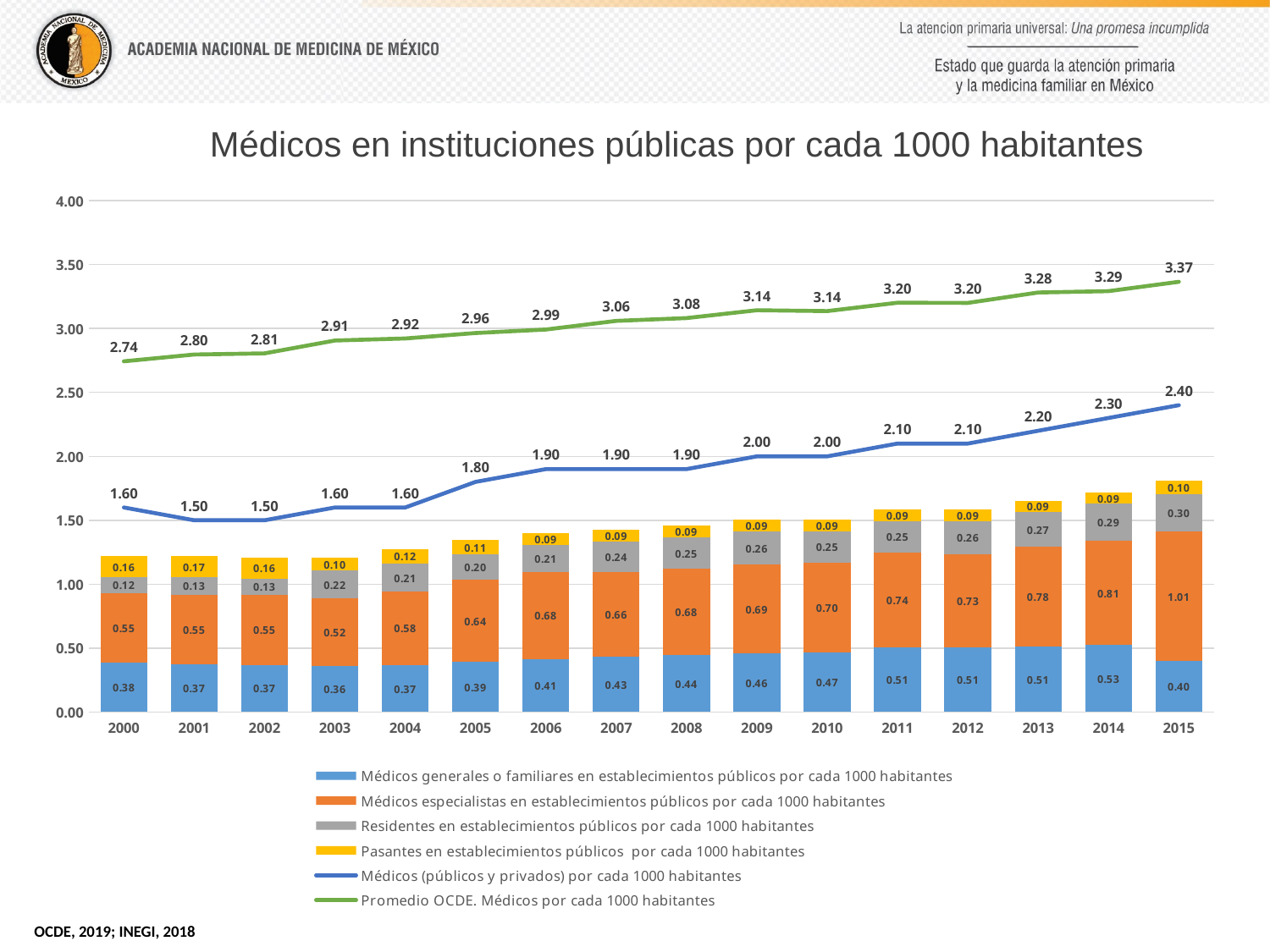
What is the total of the stacked bar for 2015? 1.81 How many series does the legend list? 6 What is the difference between the Promedio OCDE value and the Médicos (públicos y privados) value in 2015? 0.97 Which is larger: the Residentes value in 2015 or the Pasantes value in 2015? Residentes (0.30) What is the value of Médicos (públicos y privados) por cada 1000 habitantes in 2015? 2.40 What is the Promedio OCDE value for 2000? 2.74 Does the Promedio OCDE line rise or fall from 2000 to 2015? Rises What is the value for Médicos especialistas en establecimientos públicos in 2015? 1.01 What kind of chart is this? Combined stacked bar and line chart In which year is the value for Médicos generales o familiares highest? 2014 In which year is the value for Médicos generales o familiares lowest? 2003 How many years are shown on the x axis? 16